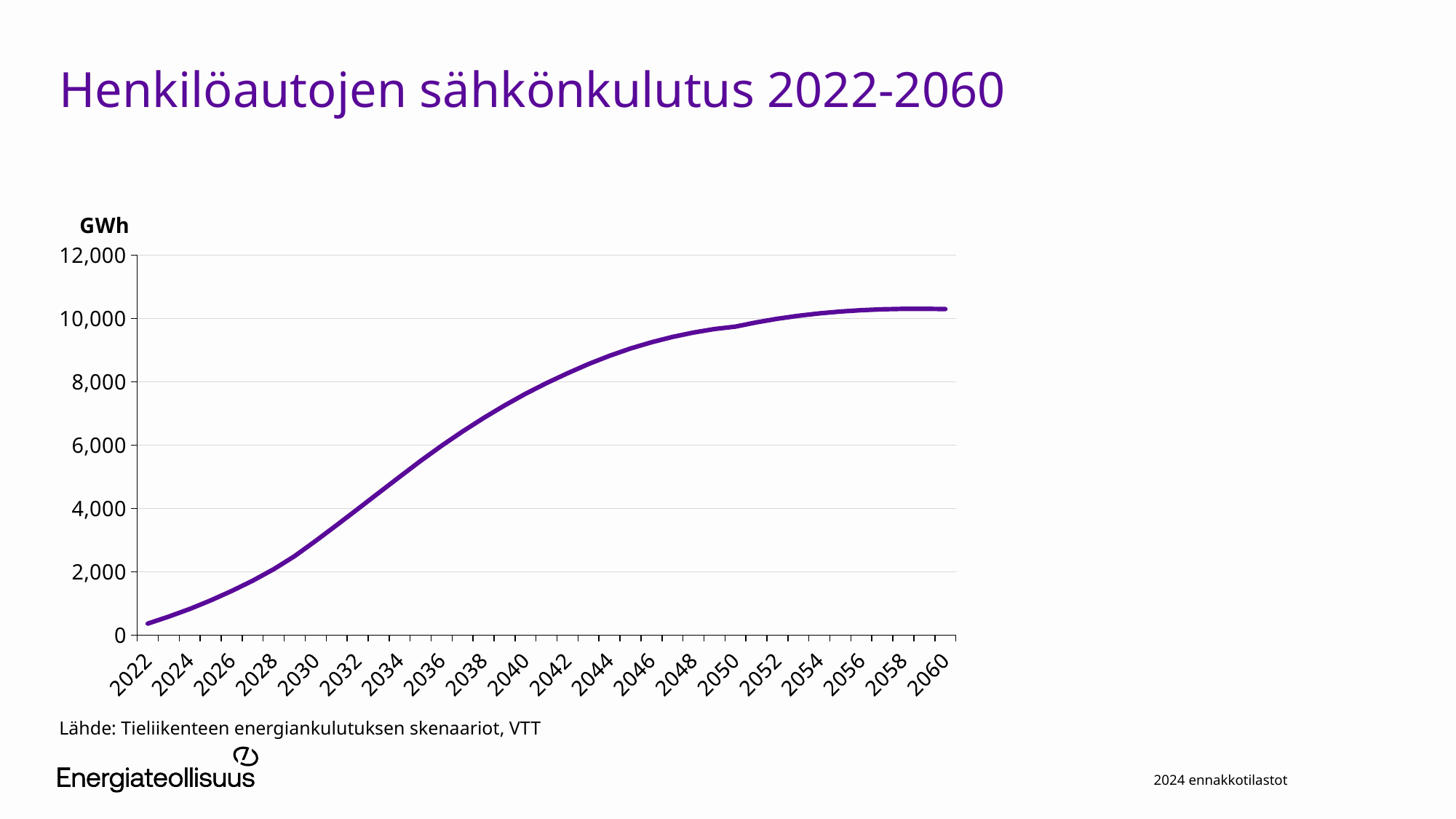
How many year labels are shown on the x axis? 20 Is the value for 2034 greater or less than 4,000? greater Is the value for 2030 greater or less than 4,000? less Is the value for 2040 greater or less than 6,000? greater What is the title of the chart? Henkilöautojen sähkönkulutus 2022-2060 What kind of chart is shown on the slide? line chart Do the values rise or fall from 2022 to 2060? rise Which year has the lowest value on the chart? 2022 What unit is shown on the vertical axis of the chart? GWh